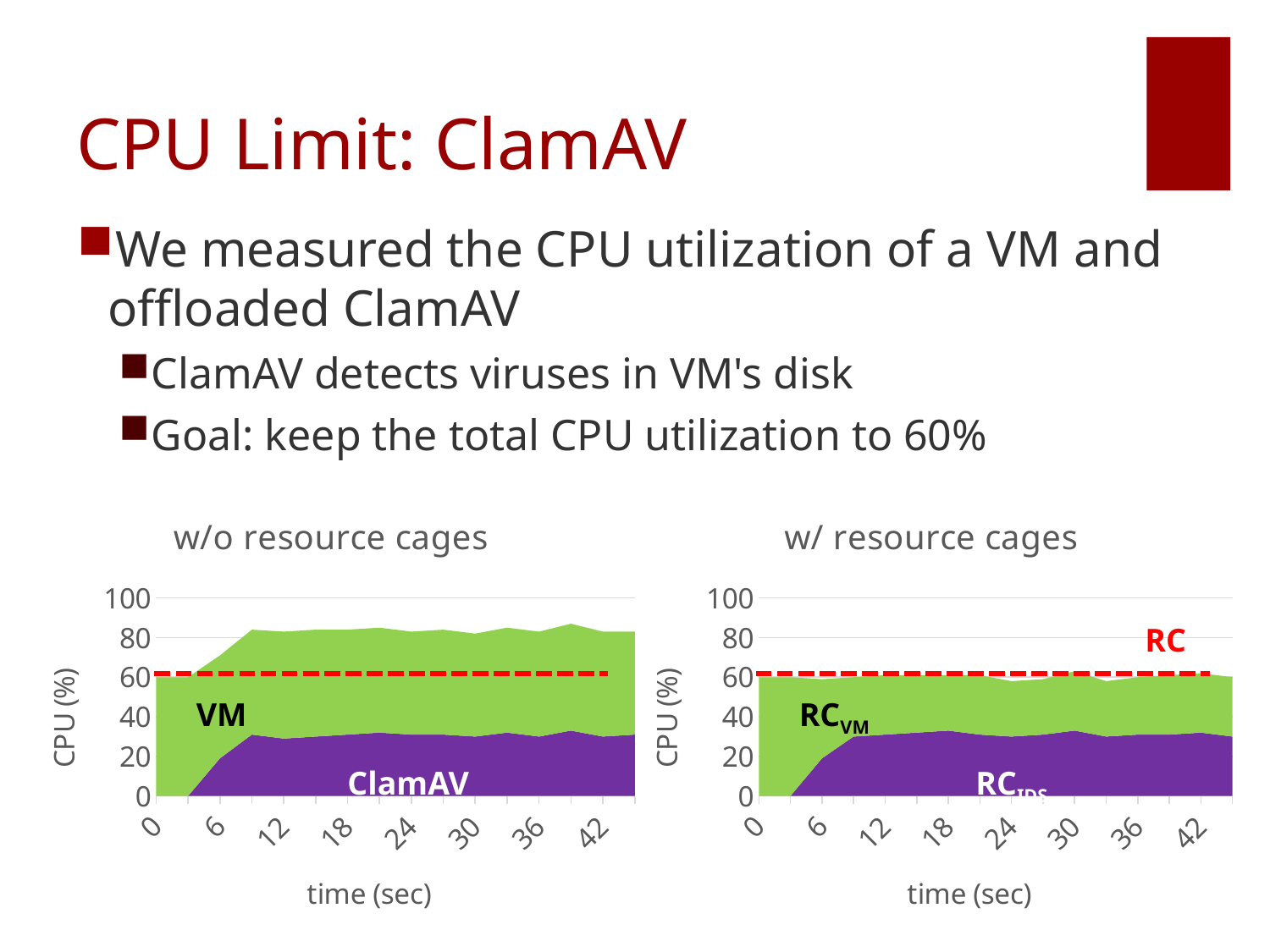
Which chart shows the larger total CPU utilization at time 24, 'w/o resource cages' or 'w/ resource cages'? w/o resource cages In the 'w/o resource cages' chart, is the VM value at time 0 greater or less than 40? greater In the 'w/o resource cages' chart, is the total CPU utilization at time 24 greater or less than 60? greater What kind of chart is the 'w/o resource cages' chart? area chart In the 'w/ resource cages' chart, is the total CPU utilization at time 24 greater or less than 80? less At what CPU (%) value is the red dashed line drawn in the 'w/ resource cages' chart? 60 What is the x-axis label of the 'w/o resource cages' chart? time (sec) How many tick labels are shown on the x axis of the 'w/ resource cages' chart? 8 In the 'w/o resource cages' chart, does the total CPU utilization rise or fall between time 0 and time 12? rise